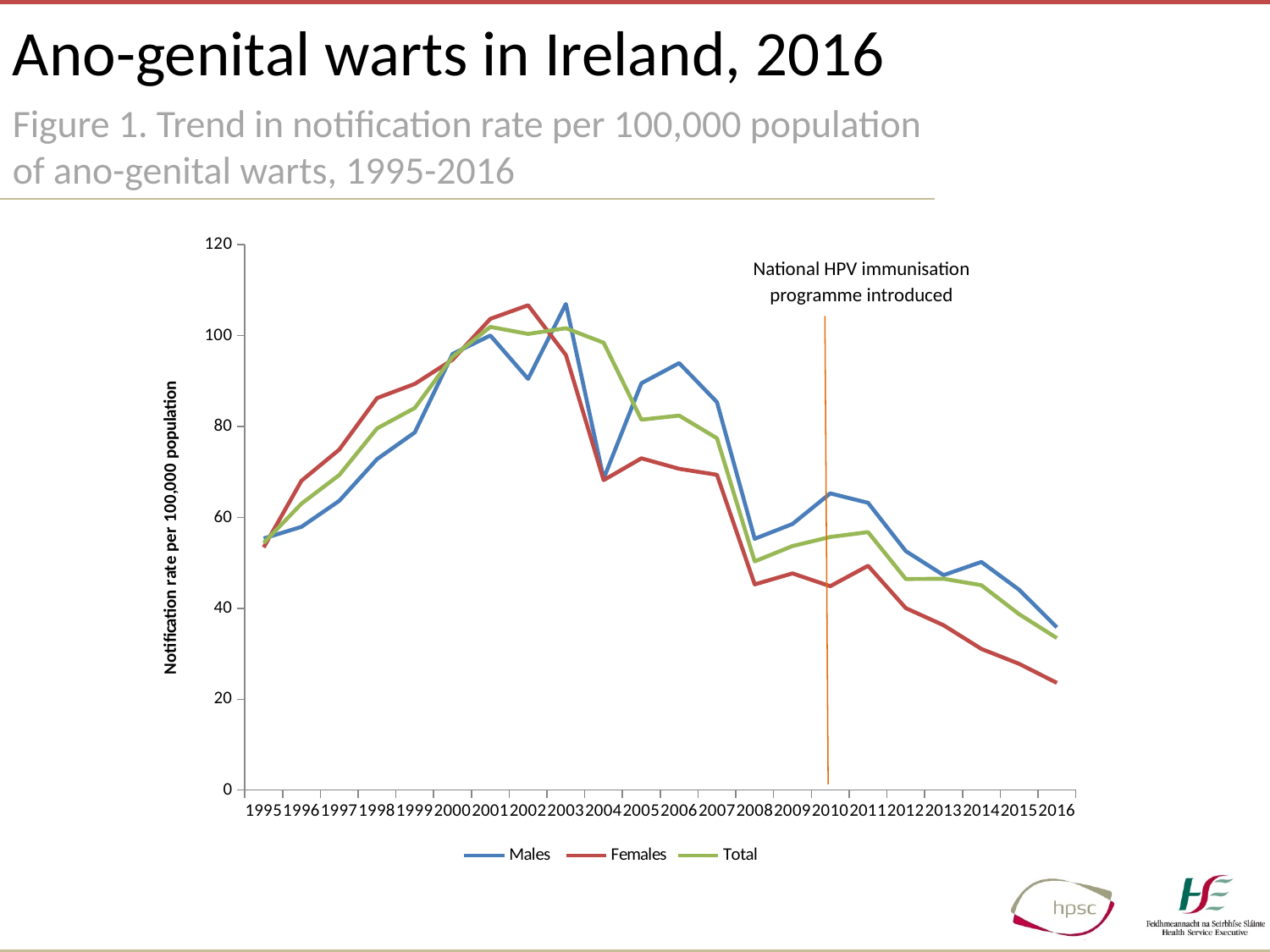
Is the value for Females in 2016 greater or less than 40? less Is the value for Males in 1995 greater or less than 60? less In 2016, which is larger, the Males value or the Females value? Males In which year does the Females series reach its lowest value? 2016 Between 2011 and 2016, do the Females values rise or fall? Fall Is the value for Males in 2003 greater or less than 100? greater In which year does the Males series reach its highest value? 2003 How many years are plotted along the x axis? 22 In 2006, which is larger, the Males value or the Females value? Males How many series does the legend list? 3 What event does the vertical orange line on the chart mark? National HPV immunisation programme introduced What kind of chart is shown on the slide? Line chart